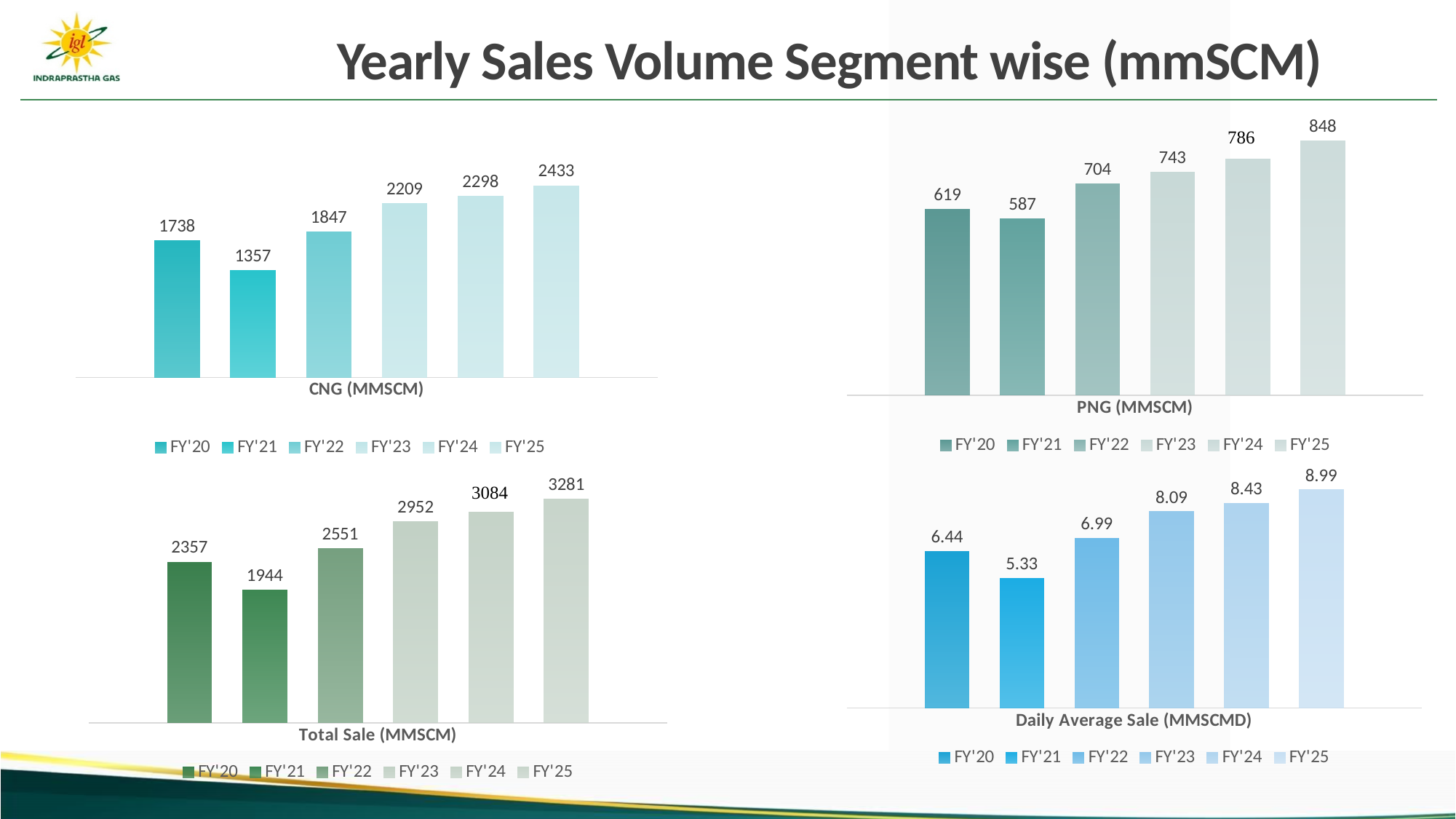
How many bars are plotted in the PNG (MMSCM) chart? 6 What kind of chart is the Daily Average Sale (MMSCMD) chart? Bar chart In the Daily Average Sale (MMSCMD) chart, what is the value for FY'22? 6.99 In the CNG (MMSCM) chart, which is larger, the value for FY'20 or the value for FY'22? FY'22 How many entries does the legend of the Total Sale (MMSCM) chart list? 6 In the CNG (MMSCM) chart, which fiscal year has the lowest value? FY'21 In the PNG (MMSCM) chart, what is the value for FY'21? 587 In the Total Sale (MMSCM) chart, what is the difference between the FY'25 and FY'20 values? 924 In the Daily Average Sale (MMSCMD) chart, what is the difference between the FY'25 and FY'24 values? 0.56 In the Total Sale (MMSCM) chart, what is the value for FY'25? 3281 In the CNG (MMSCM) chart, what is the value for FY'23? 2209 In the PNG (MMSCM) chart, which fiscal year has the highest value? FY'25